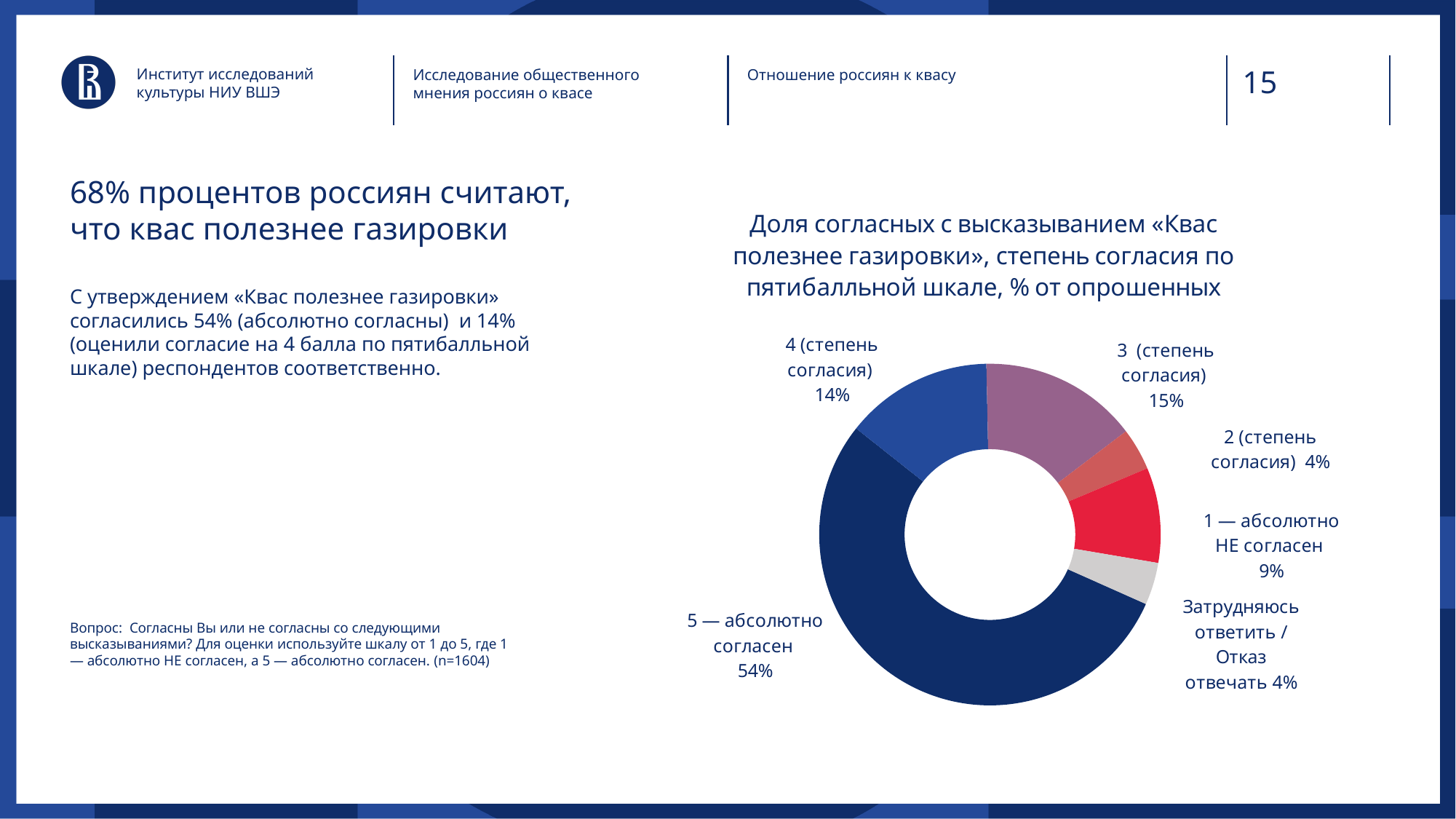
What is the title of the chart? Доля согласных с высказыванием «Квас полезнее газировки», степень согласия по пятибалльной шкале, % от опрошенных What is the difference between the share for "5 — абсолютно согласен" and the share for "1 — абсолютно НЕ согласен"? 45% What kind of chart is shown on the slide? Pie chart (donut) Which is larger: the share for 3 (степень согласия) or the share for 4 (степень согласия)? 3 (степень согласия) Which category has the largest share in the chart? 5 — абсолютно согласен What share of respondents gave a rating of 4 (степень согласия)? 14% What share of respondents gave a rating of 3 (степень согласия)? 15% How many categories (slices) does the chart show? 6 What is the combined share of respondents who rated 4 or 5 (степень согласия)? 68% What share of respondents answered "5 — абсолютно согласен"? 54% What share of respondents chose "Затрудняюсь ответить / Отказ отвечать"? 4% What share of respondents answered "1 — абсолютно НЕ согласен"? 9%